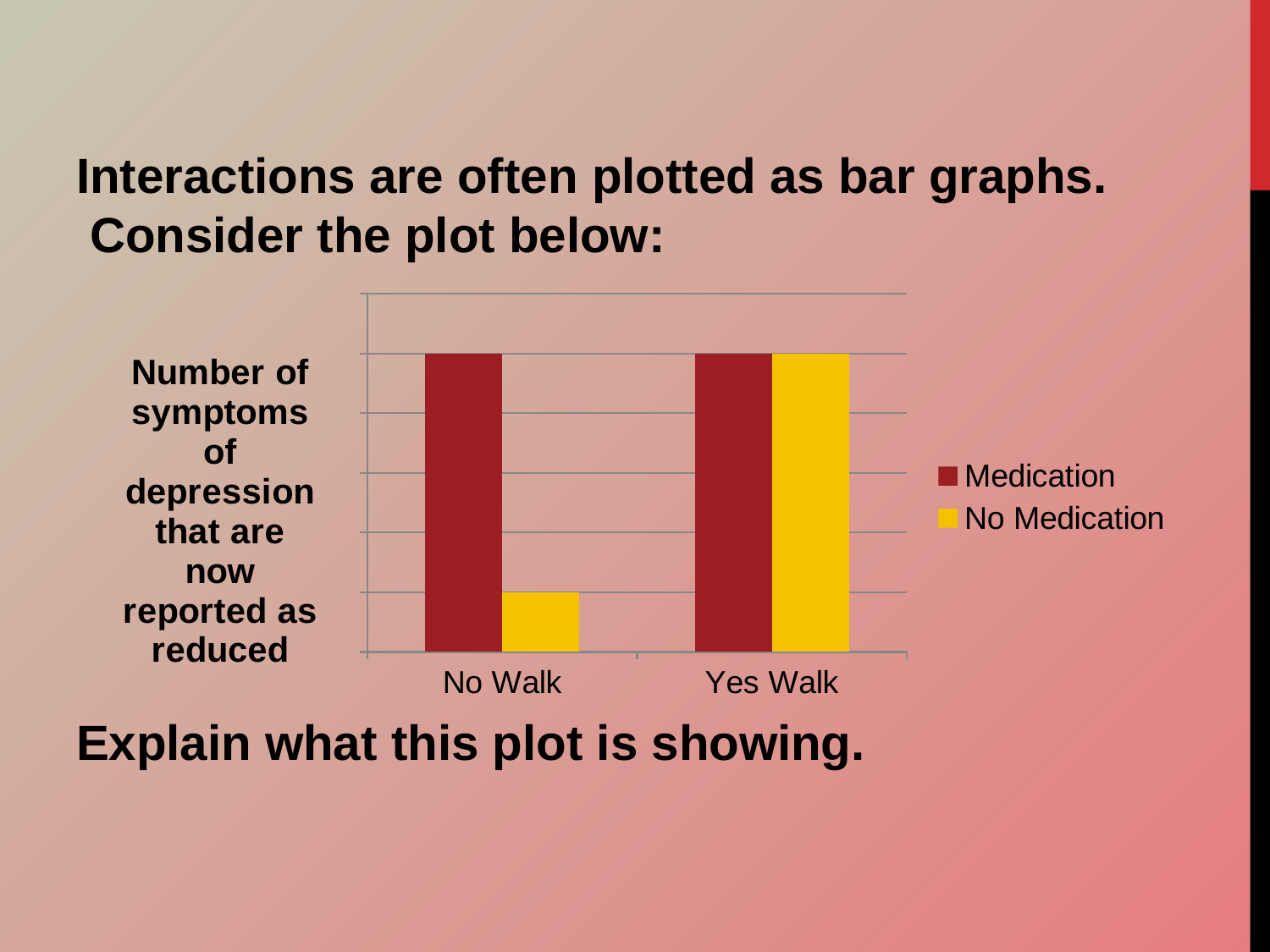
Does the No Medication series rise or fall from No Walk to Yes Walk? Rise Which category on the x axis is listed first, on the left? No Walk In the No Walk category, which series has the larger value, Medication or No Medication? Medication For the No Medication series, which category has the lower value? No Walk Is the No Medication value larger for No Walk or for Yes Walk? Yes Walk For the No Medication series, which category has the higher value? Yes Walk What kind of chart is shown on the slide? Bar chart How many categories are shown on the x axis of the chart? 2 What are the two series listed in the chart's legend? Medication and No Medication How many series does the chart's legend list? 2 What is the label on the vertical axis of the chart? Number of symptoms of depression that are now reported as reduced